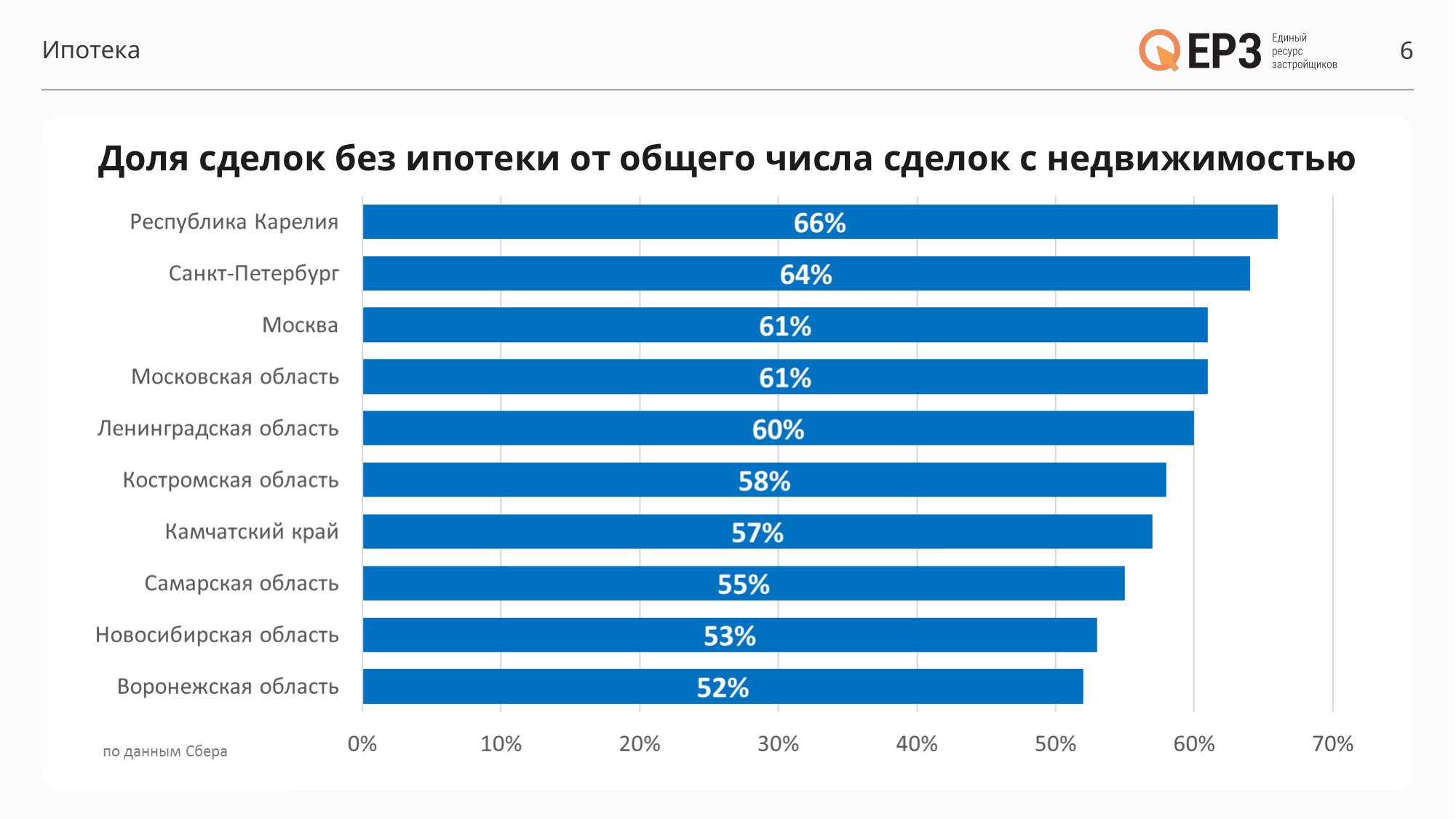
What is the value for Санкт-Петербург? 64% What is the title of the chart? Доля сделок без ипотеки от общего числа сделок с недвижимостью Which is larger, the value for Камчатский край or the value for Самарская область? Камчатский край What is the value for Республика Карелия? 66% What kind of chart is shown on the slide? bar chart How many regions are shown in the chart? 10 Which region has the lowest share of deals without a mortgage? Воронежская область Which region has the highest share of deals without a mortgage? Республика Карелия What is the difference between the values for Республика Карелия and Воронежская область? 14% Is the value for Новосибирская область greater or less than 50%? greater What is the value for Воронежская область? 52% What is the value for Костромская область? 58%